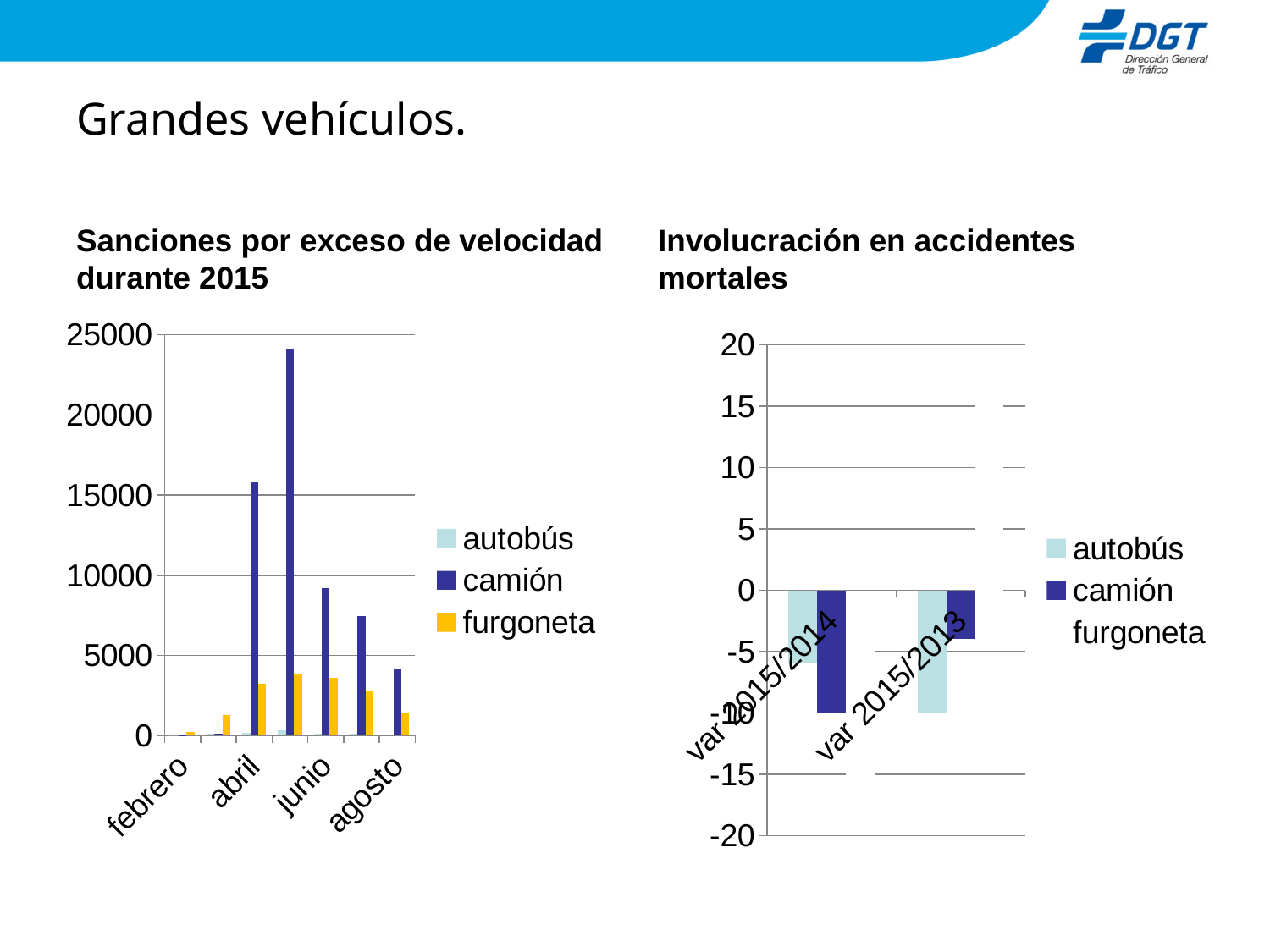
In 'Sanciones por exceso de velocidad durante 2015', is the tallest furgoneta bar greater or less than 5000? less In 'Involucración en accidentes mortales', which series shows the larger decrease for var 2015/2013, autobús or camión? autobús In 'Sanciones por exceso de velocidad durante 2015', is the tallest camión bar greater or less than 20000? greater What type of chart is 'Sanciones por exceso de velocidad durante 2015'? bar chart How many series does the legend of 'Sanciones por exceso de velocidad durante 2015' list? 3 What is the highest value shown on the vertical axis of 'Sanciones por exceso de velocidad durante 2015'? 25000 In 'Involucración en accidentes mortales', which series shows the larger decrease for var 2015/2014, autobús or camión? camión How many categories are shown on the x axis of 'Involucración en accidentes mortales'? 2 How many series does the legend of 'Involucración en accidentes mortales' list? 3 In 'Sanciones por exceso de velocidad durante 2015', which series has the tallest bar? camión What type of chart is 'Involucración en accidentes mortales'? bar chart In 'Involucración en accidentes mortales', is the value for camión in var 2015/2014 greater or less than -5? less